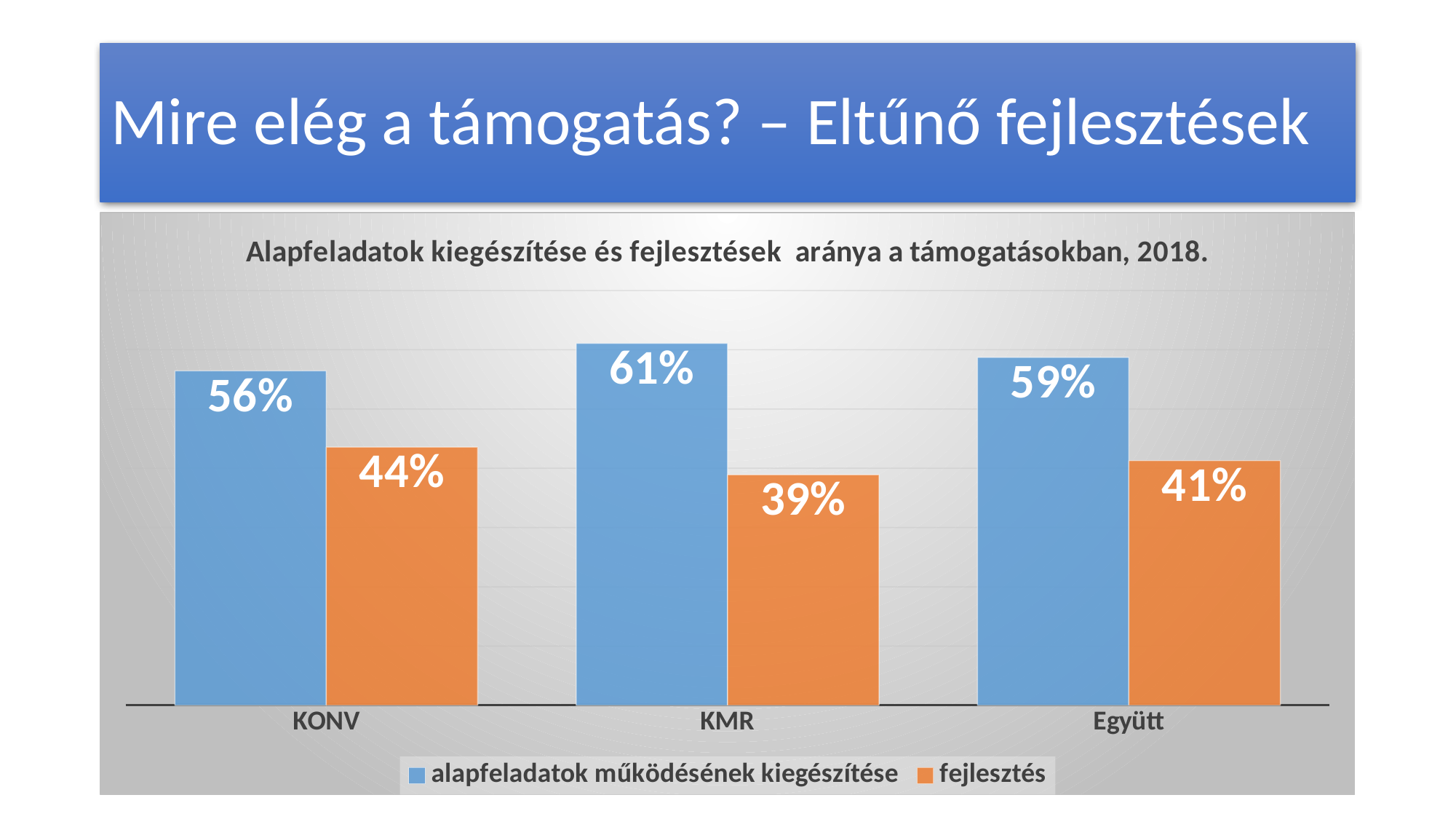
How many series does the legend list? 2 Which category has the highest value for 'alapfeladatok működésének kiegészítése'? KMR What is the difference between the 'alapfeladatok működésének kiegészítése' values for KMR and KONV? 5% What is the value for 'alapfeladatok működésének kiegészítése' for KONV? 56% What is the value for 'fejlesztés' for KMR? 39% Which category has the lowest value for 'fejlesztés'? KMR What is the title of the chart? Alapfeladatok kiegészítése és fejlesztések aránya a támogatásokban, 2018. Which is larger for Együtt: 'alapfeladatok működésének kiegészítése' or 'fejlesztés'? alapfeladatok működésének kiegészítése How many categories are shown on the x axis? 3 What is the value for 'fejlesztés' for Együtt? 41% What kind of chart is shown on the slide? bar chart What is the difference between the 'alapfeladatok működésének kiegészítése' and 'fejlesztés' values for KONV? 12%